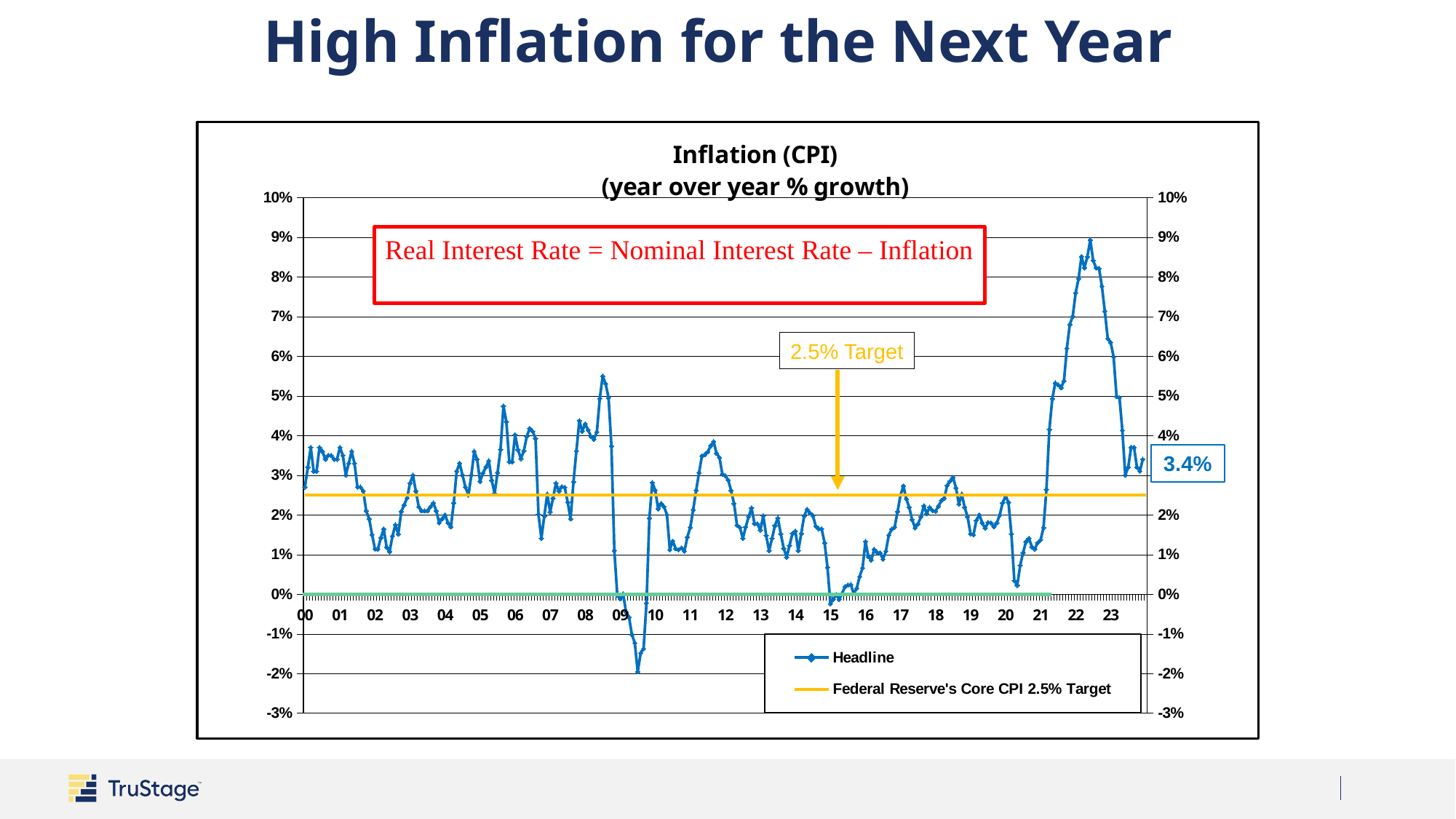
Which is larger: the latest Headline inflation value or the Federal Reserve's 2.5% target? The latest Headline value (3.4%) What kind of chart is shown on the slide? Line chart By how many percentage points does the latest Headline value of 3.4% exceed the 2.5% target? 0.9 percentage points How many series does the legend list? 2 In which year does the Headline series reach its lowest value? 09 What is the most recent Headline inflation value labelled on the chart? 3.4% Is the peak Headline inflation value in 2022 greater or less than 8%? greater What is the title of the chart? Inflation (CPI) (year over year % growth) Does the Headline series rise or fall from its 2022 peak to 2023? Fall Is the lowest Headline inflation value in 2009 greater or less than -1%? less In which year does the Headline series reach its highest value? 22 What is the Federal Reserve's Core CPI target shown on the chart? 2.5%